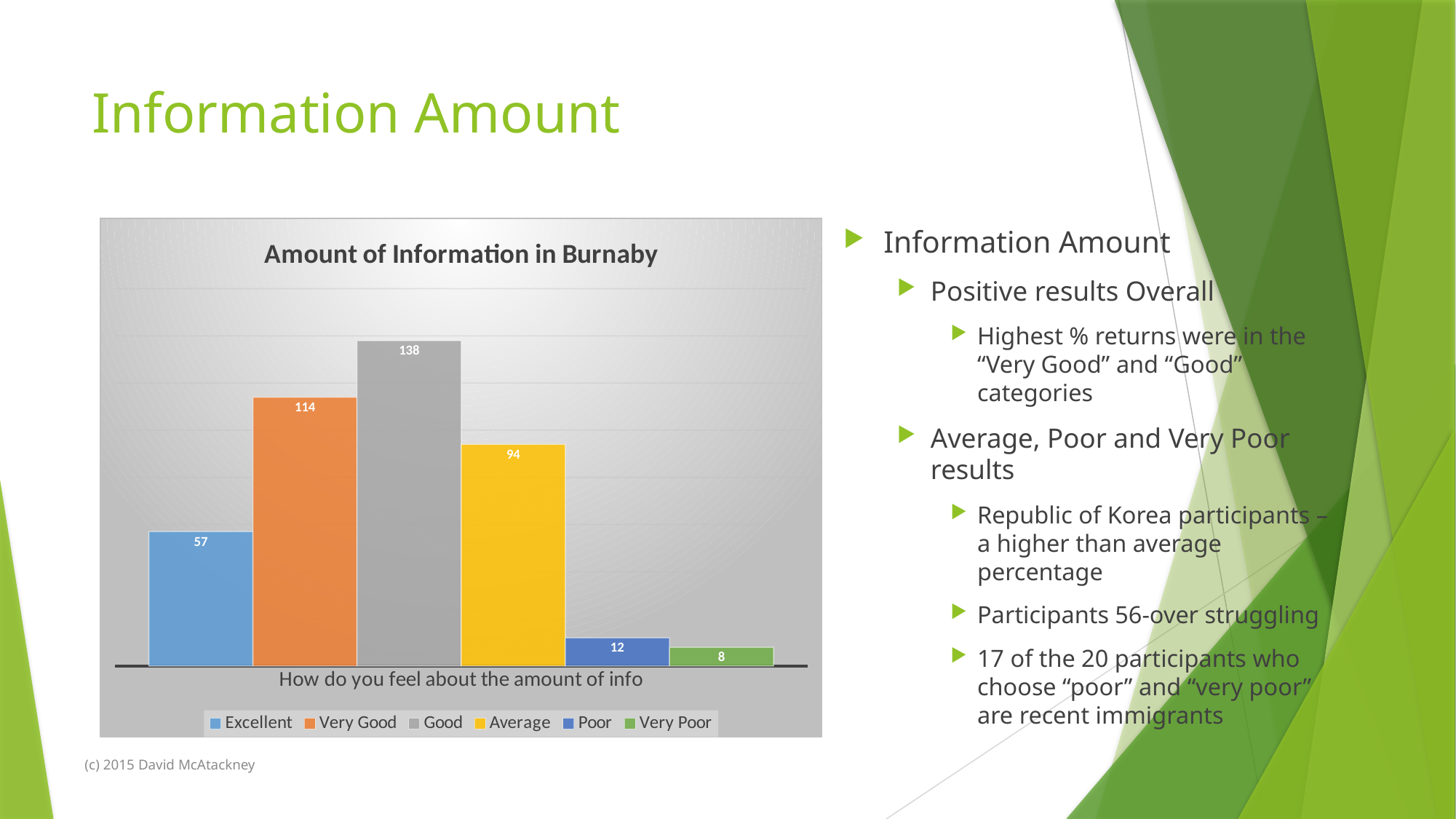
Which category has the highest value? Good What kind of chart is shown? Bar chart Which category has the lowest value? Very Poor What is the difference between the values for Average and Poor? 82 What is the value for Very Good? 114 How many series does the legend list? 6 What is the value for Good? 138 What is the value for Excellent? 57 What is the value for Very Poor? 8 Which is larger, the value for Excellent or the value for Average? Average What is the difference between the values for Good and Very Good? 24 What is the title of the chart? Amount of Information in Burnaby